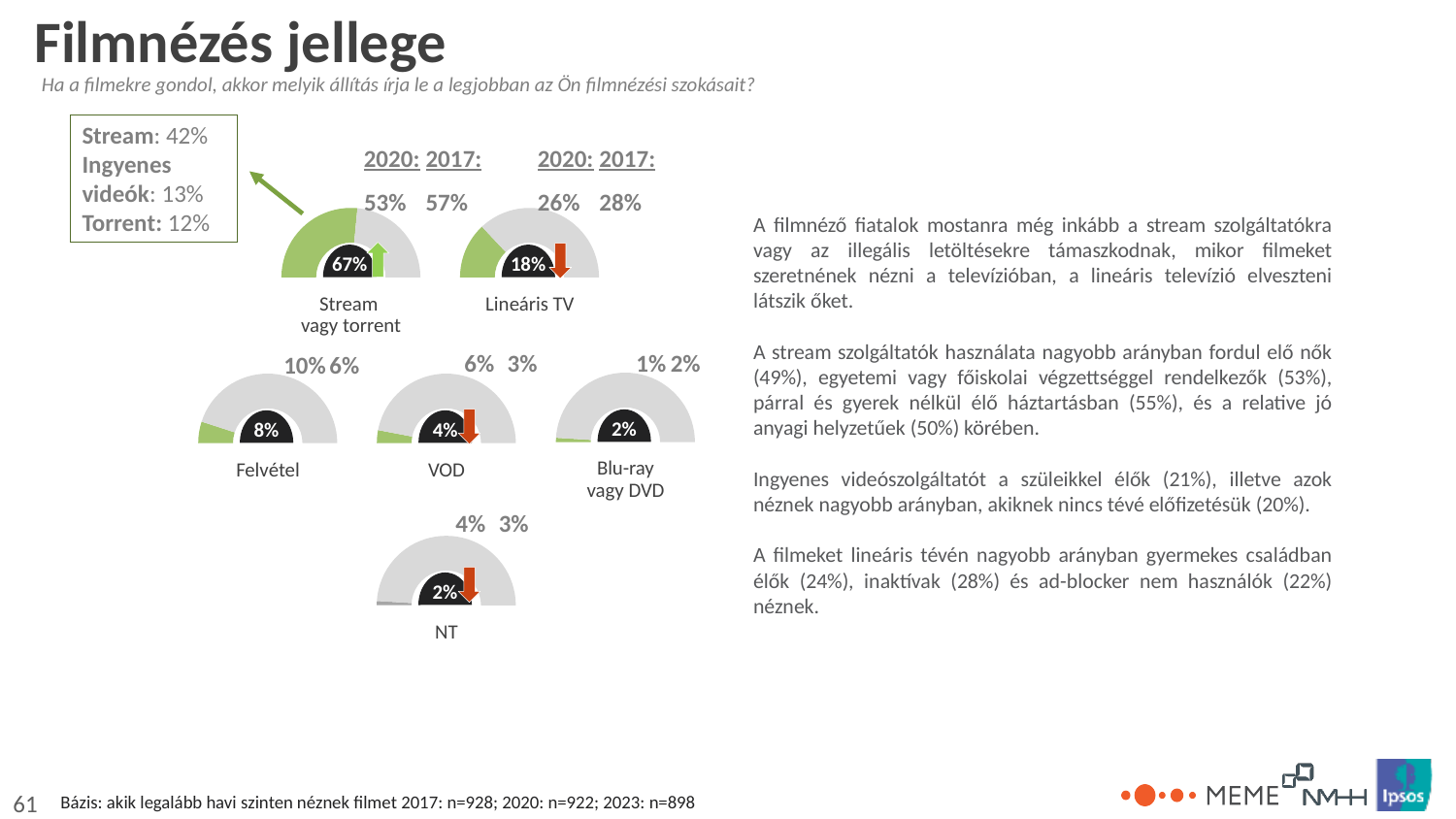
Which gauge on the slide shows the highest current value? Stream vagy torrent What is the value shown in the centre of the 'Stream vagy torrent' gauge? 67% Which is larger, the 'Felvétel' gauge value or the 'VOD' gauge value? Felvétel What is the value shown in the centre of the 'Blu-ray vagy DVD' gauge? 2% What is the value shown in the centre of the 'Felvétel' gauge? 8% What kind of chart is used to show each category on the slide? Gauge (semi-circle doughnut) chart What is the difference between the 'Stream vagy torrent' gauge value and the 'Lineáris TV' gauge value? 49 percentage points What 2020 value is printed above the 'Lineáris TV' gauge? 26% What is the value shown in the centre of the 'Lineáris TV' gauge? 18% What is the value shown in the centre of the 'VOD' gauge? 4% How many gauge charts are shown on the slide? 6 What 2017 value is printed above the 'Stream vagy torrent' gauge? 57%